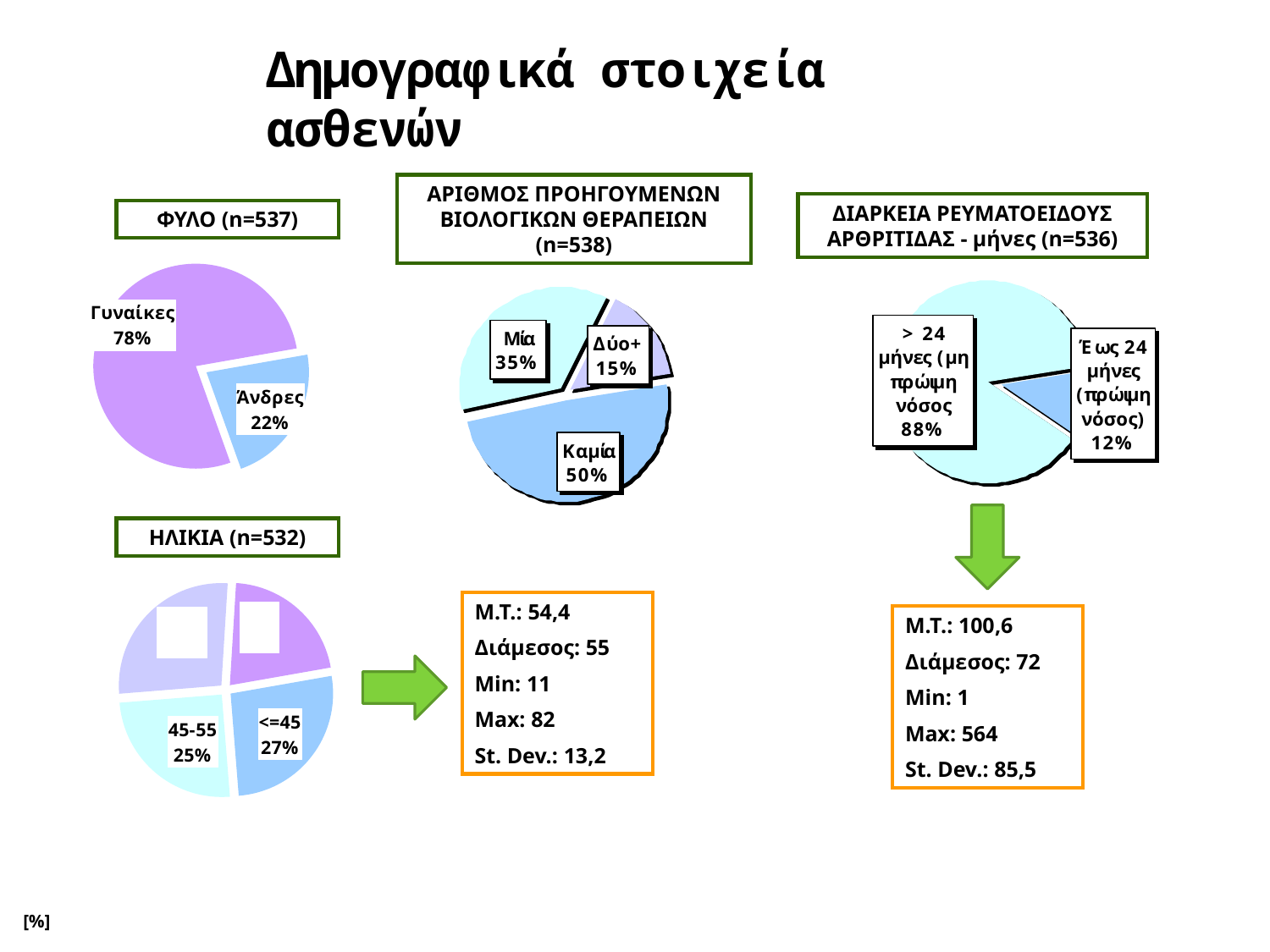
In the ΑΡΙΘΜΟΣ ΠΡΟΗΓΟΥΜΕΝΩΝ ΒΙΟΛΟΓΙΚΩΝ ΘΕΡΑΠΕΙΩΝ (n=538) pie chart, how many slices are there? 3 In the ΑΡΙΘΜΟΣ ΠΡΟΗΓΟΥΜΕΝΩΝ ΒΙΟΛΟΓΙΚΩΝ ΘΕΡΑΠΕΙΩΝ (n=538) pie chart, which is larger, Μία or Δύο+? Μία In the ΑΡΙΘΜΟΣ ΠΡΟΗΓΟΥΜΕΝΩΝ ΒΙΟΛΟΓΙΚΩΝ ΘΕΡΑΠΕΙΩΝ (n=538) pie chart, which category has the smallest share? Δύο+ In the ΔΙΑΡΚΕΙΑ ΡΕΥΜΑΤΟΕΙΔΟΥΣ ΑΡΘΡΙΤΙΔΑΣ - μήνες (n=536) pie chart, what share is Έως 24 μήνες (πρώιμη νόσος)? 12% In the ΑΡΙΘΜΟΣ ΠΡΟΗΓΟΥΜΕΝΩΝ ΒΙΟΛΟΓΙΚΩΝ ΘΕΡΑΠΕΙΩΝ (n=538) pie chart, what share is Δύο+? 15% In the ΗΛΙΚΙΑ (n=532) pie chart, what share is the <=45 slice? 27% In the ΦΥΛΟ (n=537) pie chart, what is the difference between the Γυναίκες and Άνδρες shares? 56% What kind of chart is used for ΦΥΛΟ (n=537)? Pie chart